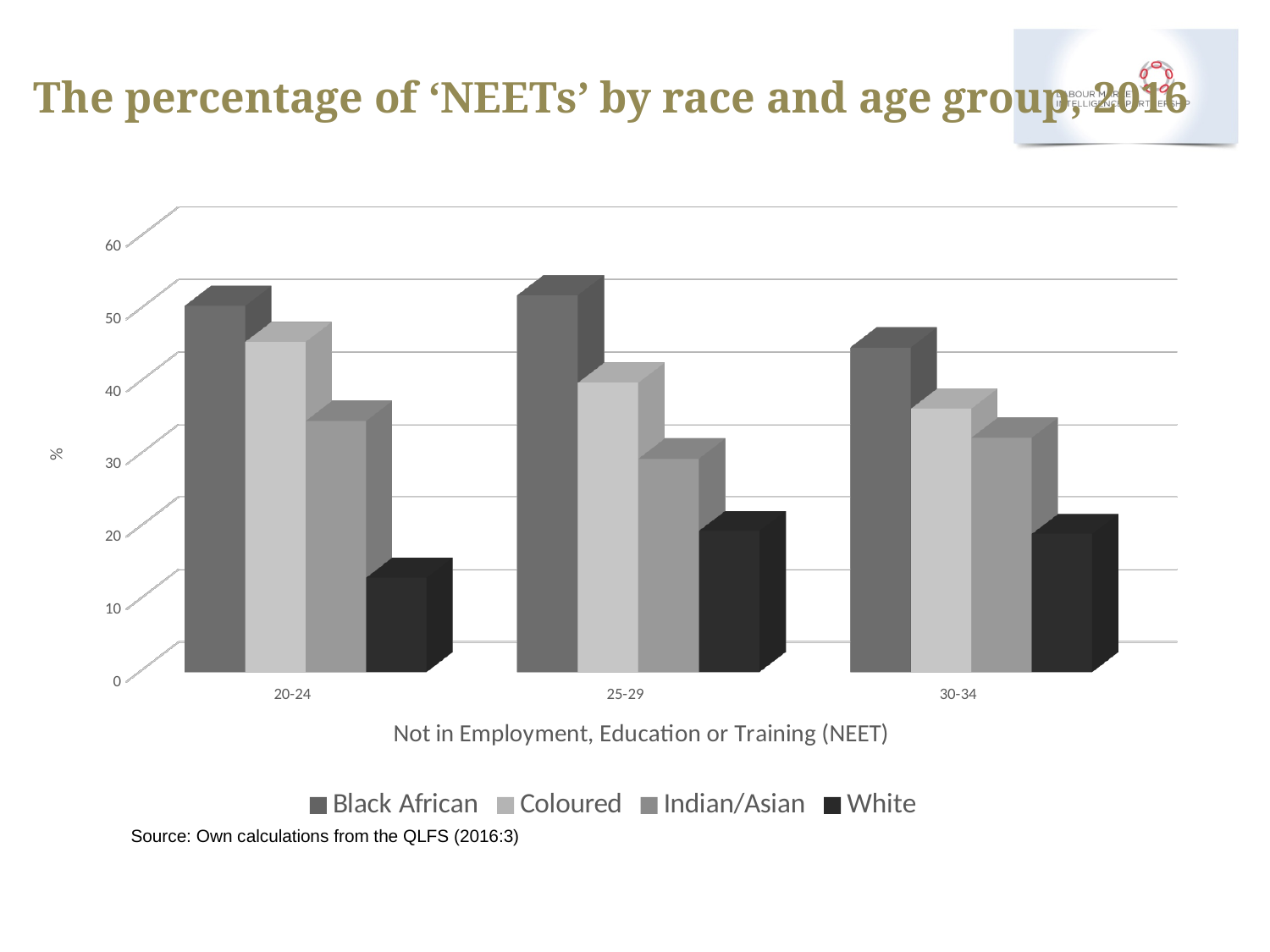
Is the value for White in the 20-24 age group greater or less than 20? less Which is larger in the 30-34 age group, the value for Coloured or the value for White? Coloured Which race group has the lowest NEET percentage in the 25-29 age group? White Is the value for Black African in the 25-29 age group greater or less than 40? greater What is the title of the chart on the slide? The percentage of 'NEETs' by race and age group, 2016 Is the value for Indian/Asian in the 25-29 age group greater or less than 40? less What kind of chart is shown on the slide? bar chart Which race group has the lowest NEET percentage in the 30-34 age group? White Which race group has the highest NEET percentage in the 20-24 age group? Black African How many series does the legend list? 4 What is the label on the vertical axis? % How many age groups are shown on the x axis? 3